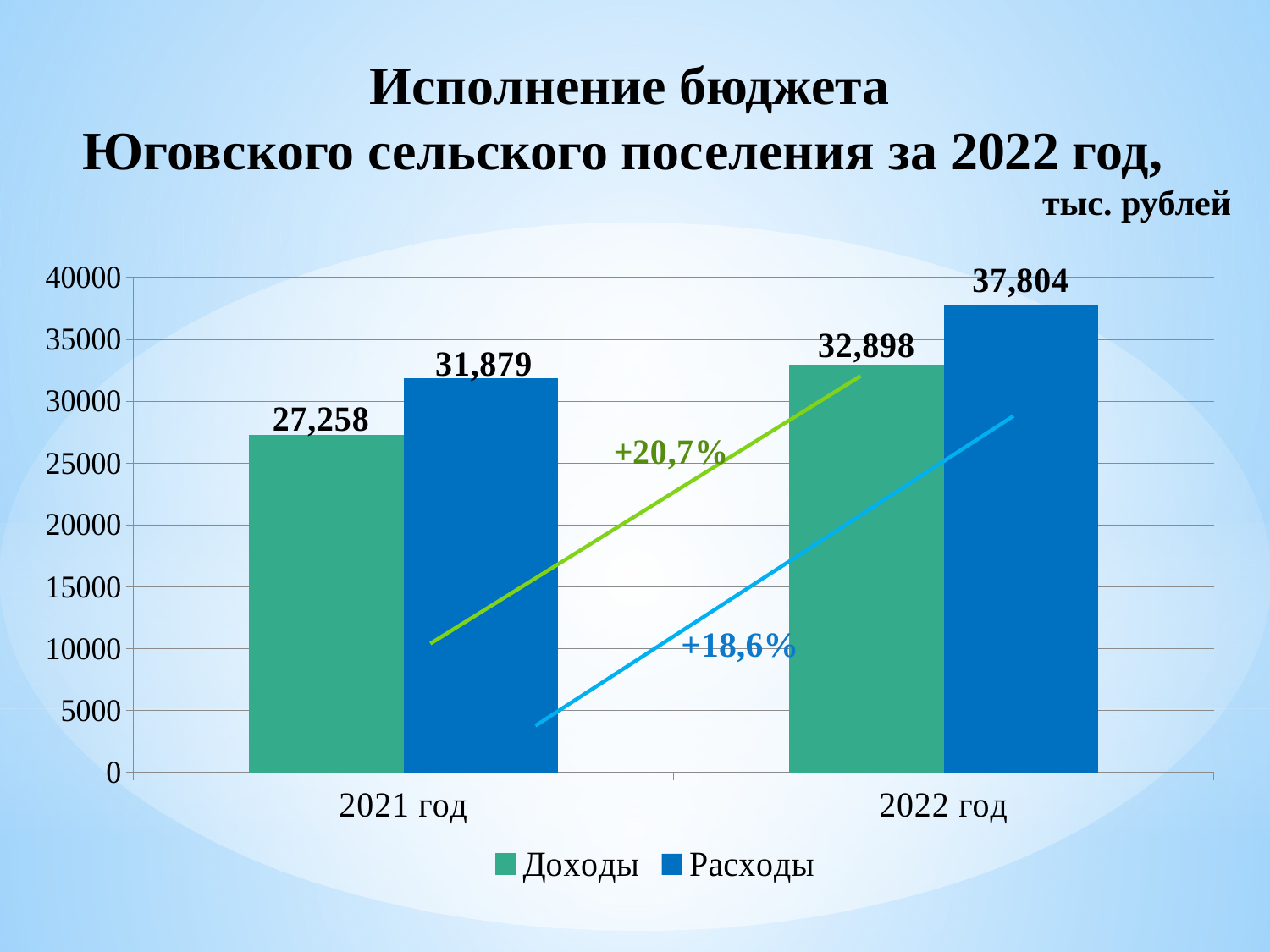
What is the value of Расходы for 2022 год? 37,804 What percentage increase is shown next to the green line for Доходы? +20,7% What is the value of Доходы for 2022 год? 32,898 By how much did Доходы increase from 2021 год to 2022 год? 5,640 Which bar has the highest value on the chart? Расходы, 2022 год What is the value of Доходы for 2021 год? 27,258 How many series does the legend list? 2 What is the value of Расходы for 2021 год? 31,879 What is the difference between Расходы and Доходы for 2022 год? 4,906 Which bar has the lowest value on the chart? Доходы, 2021 год What kind of chart is shown on the slide? Bar chart Which is larger for 2021 год, Доходы or Расходы? Расходы